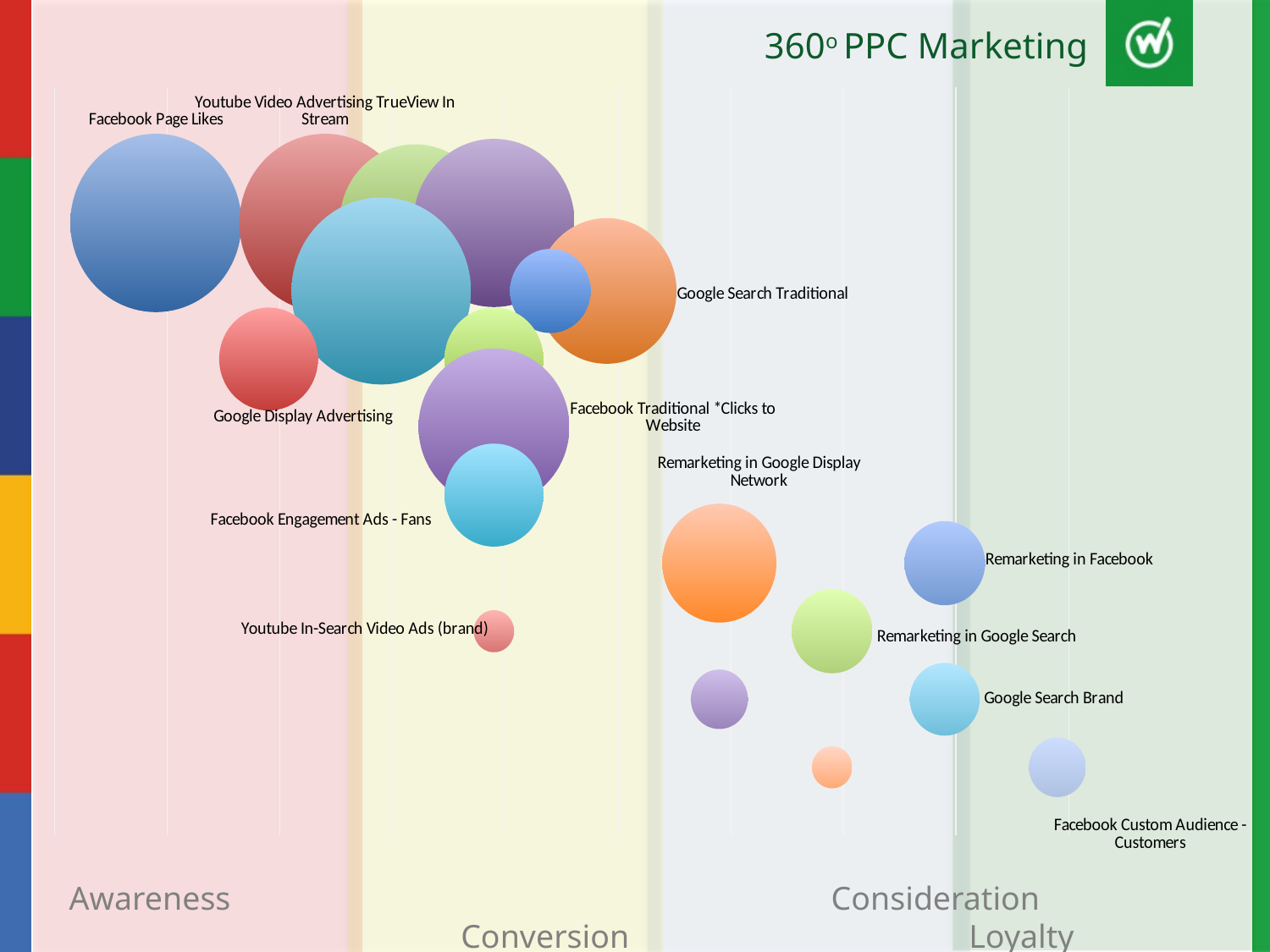
Which bubble is larger, Remarketing in Google Display Network or Remarketing in Google Search? Remarketing in Google Display Network Which labelled bubble is the smallest on the chart? Youtube In-Search Video Ads (brand) Which bubble is larger, Facebook Page Likes or Google Display Advertising? Facebook Page Likes Which stage label appears at the far left of the chart? Awareness Which bubble is larger, Google Search Traditional or Remarketing in Facebook? Google Search Traditional How many funnel stages are labelled along the bottom of the chart? 4 What is the title of the slide's chart? 360º PPC Marketing What kind of chart is shown on the slide? Bubble chart Which labelled bubble is positioned lowest on the chart? Facebook Custom Audience - Customers Which labelled bubble is positioned furthest to the right on the chart? Facebook Custom Audience - Customers